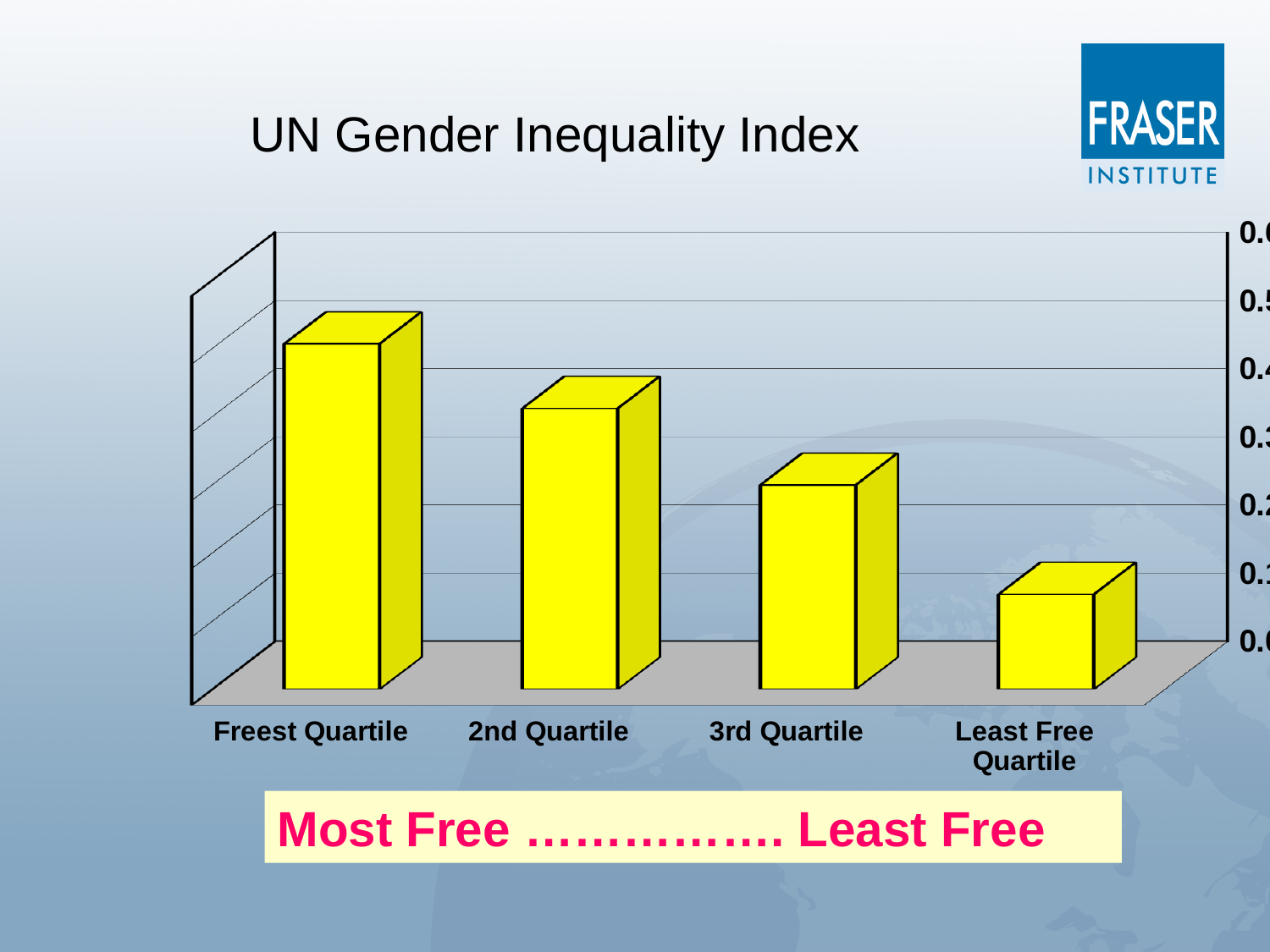
Is the value for the Least Free Quartile greater or less than 0.2? less Is the value for the 3rd Quartile greater or less than 0.2? greater What colour are the bars in the chart? yellow How many categories are plotted in the chart? 4 What is the title of the chart? UN Gender Inequality Index What kind of chart is shown on the slide? bar chart Do the values rise or fall moving from the Freest Quartile to the Least Free Quartile along the x axis? fall Which is larger, the value for the Freest Quartile or the value for the Least Free Quartile? Freest Quartile Which is larger, the value for the 2nd Quartile or the value for the 3rd Quartile? 2nd Quartile Which category has the lowest value in the chart? Least Free Quartile Which category has the highest value in the chart? Freest Quartile Is the value for the Freest Quartile greater or less than 0.4? greater